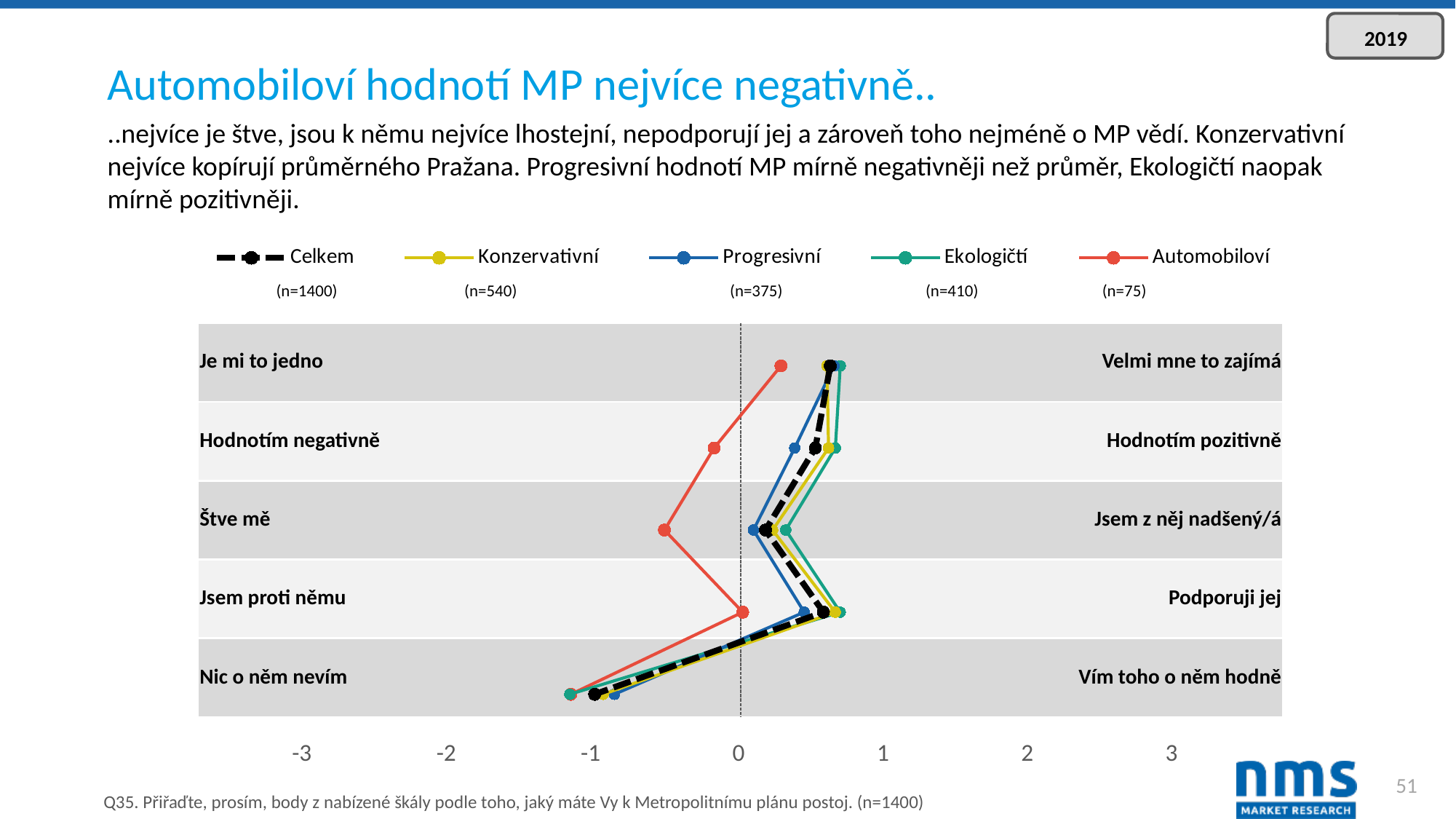
Is the Automobiloví value on the 'Štve mě / Jsem z něj nadšený/á' row greater or less than 0? less On the 'Jsem proti němu / Podporuji jej' row, which is larger: the Celkem value or the Automobiloví value? Celkem How many statement pairs (rows) are plotted on the chart? 5 What kind of chart is shown on the slide? line chart What is the sample size (n) shown for the Automobiloví series? n=75 Is the Ekologičtí value on the 'Nic o něm nevím / Vím toho o něm hodně' row greater or less than -1? less What is the sample size (n) shown for the Celkem series? n=1400 How many series does the legend list? 5 Is the Celkem value on the 'Hodnotím negativně / Hodnotím pozitivně' row greater or less than 0? greater Which series has the highest value on the 'Nic o něm nevím / Vím toho o něm hodně' row? Progresivní Which series has the lowest value on the 'Štve mě / Jsem z něj nadšený/á' row? Automobiloví